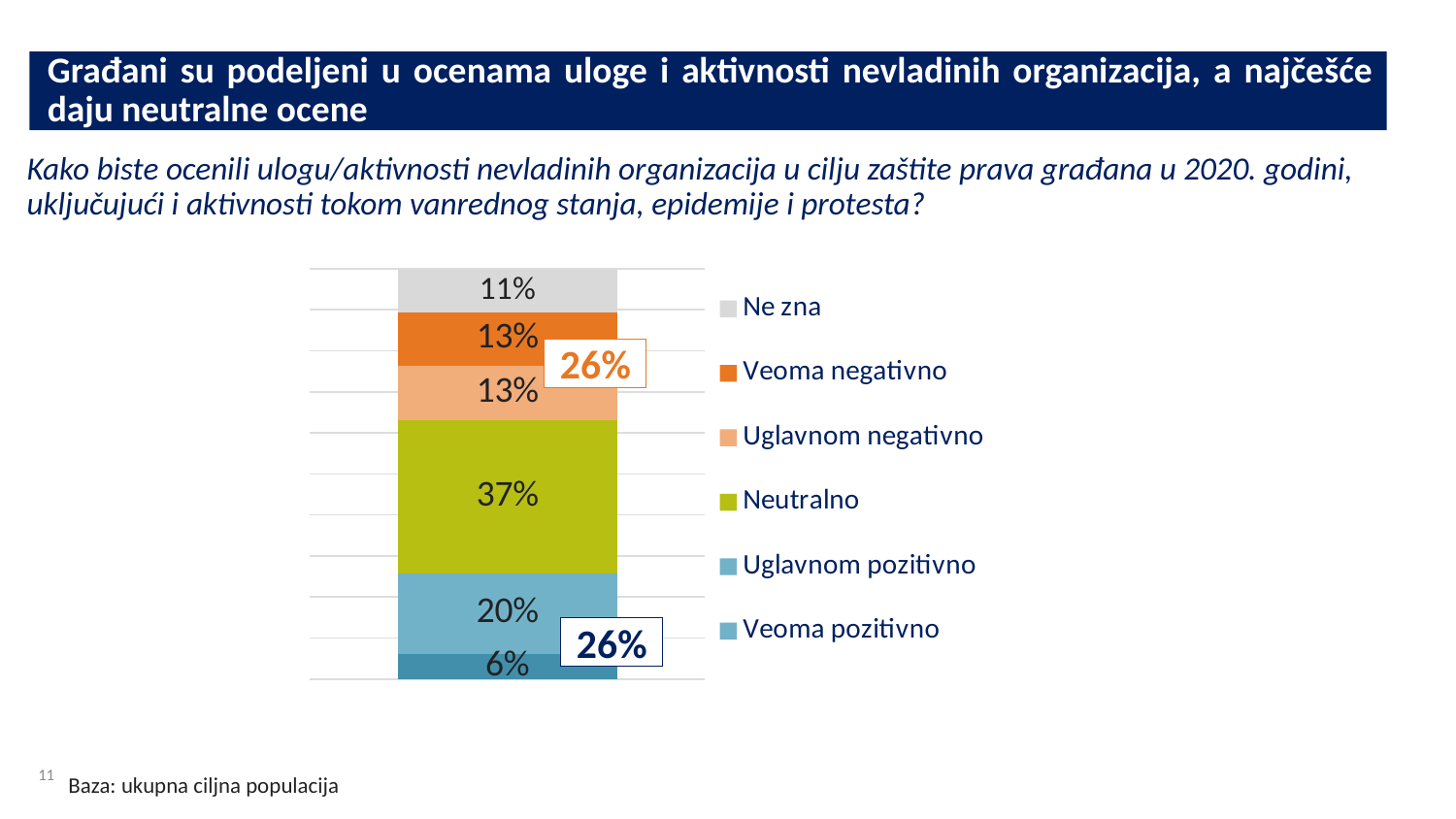
How many categories does the legend list? 6 What is the combined value of "Veoma negativno" and "Uglavnom negativno", as shown in the callout? 26% What colour is the "Neutralno" segment of the bar? Green What is the difference between the "Neutralno" value and the "Uglavnom pozitivno" value? 17% Which category has the largest share of the stacked bar? Neutralno What kind of chart is shown on the slide? Stacked bar chart What is the value for "Ne zna"? 11% Which category has the smallest share of the stacked bar? Veoma pozitivno What percentage of respondents answered "Neutralno"? 37% What is the value for "Uglavnom pozitivno"? 20% Which is larger, the value for "Uglavnom pozitivno" or the value for "Veoma negativno"? Uglavnom pozitivno What is the value for "Veoma pozitivno"? 6%